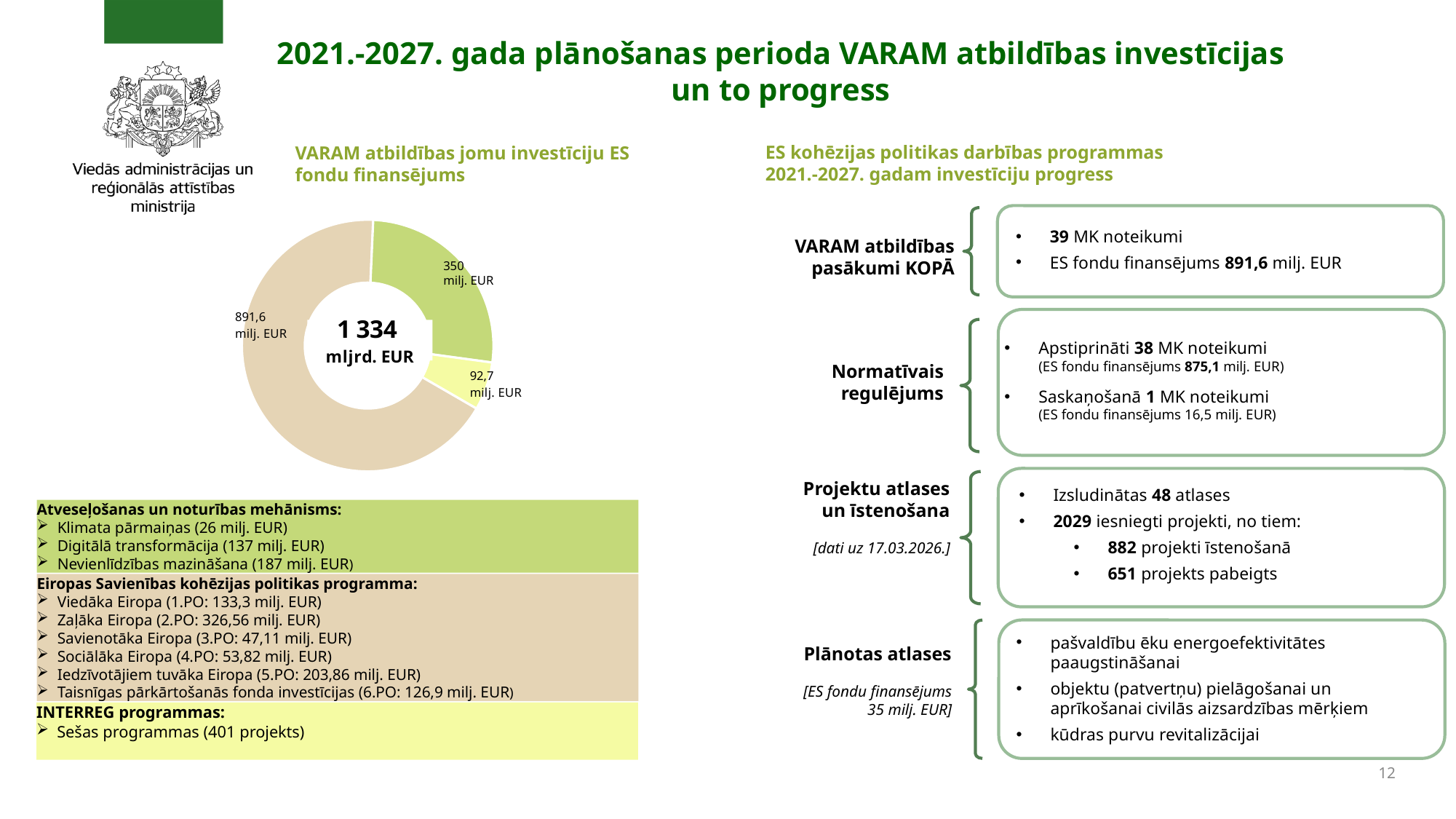
What value is labelled on the green slice of the donut chart? 350 milj. EUR What is the value of the largest slice of the donut chart? 891,6 milj. EUR What is the difference between the 891,6 milj. EUR slice and the 350 milj. EUR slice in the donut chart? 541,6 milj. EUR In the donut chart, which is larger: the green slice or the light yellow slice? The green slice (350 milj. EUR) What total value is printed in the centre of the donut chart? 1 334 mljrd. EUR What is the value of the smallest slice of the donut chart? 92,7 milj. EUR What is the title printed above the donut chart? VARAM atbildības jomu investīciju ES fondu finansējums What is the difference between the 350 milj. EUR slice and the 92,7 milj. EUR slice in the donut chart? 257,3 milj. EUR What value is labelled on the light yellow slice of the donut chart? 92,7 milj. EUR What kind of chart is shown under the heading 'VARAM atbildības jomu investīciju ES fondu finansējums'? Pie (donut) chart What value is labelled on the beige slice of the donut chart? 891,6 milj. EUR How many slices does the donut chart have? 3